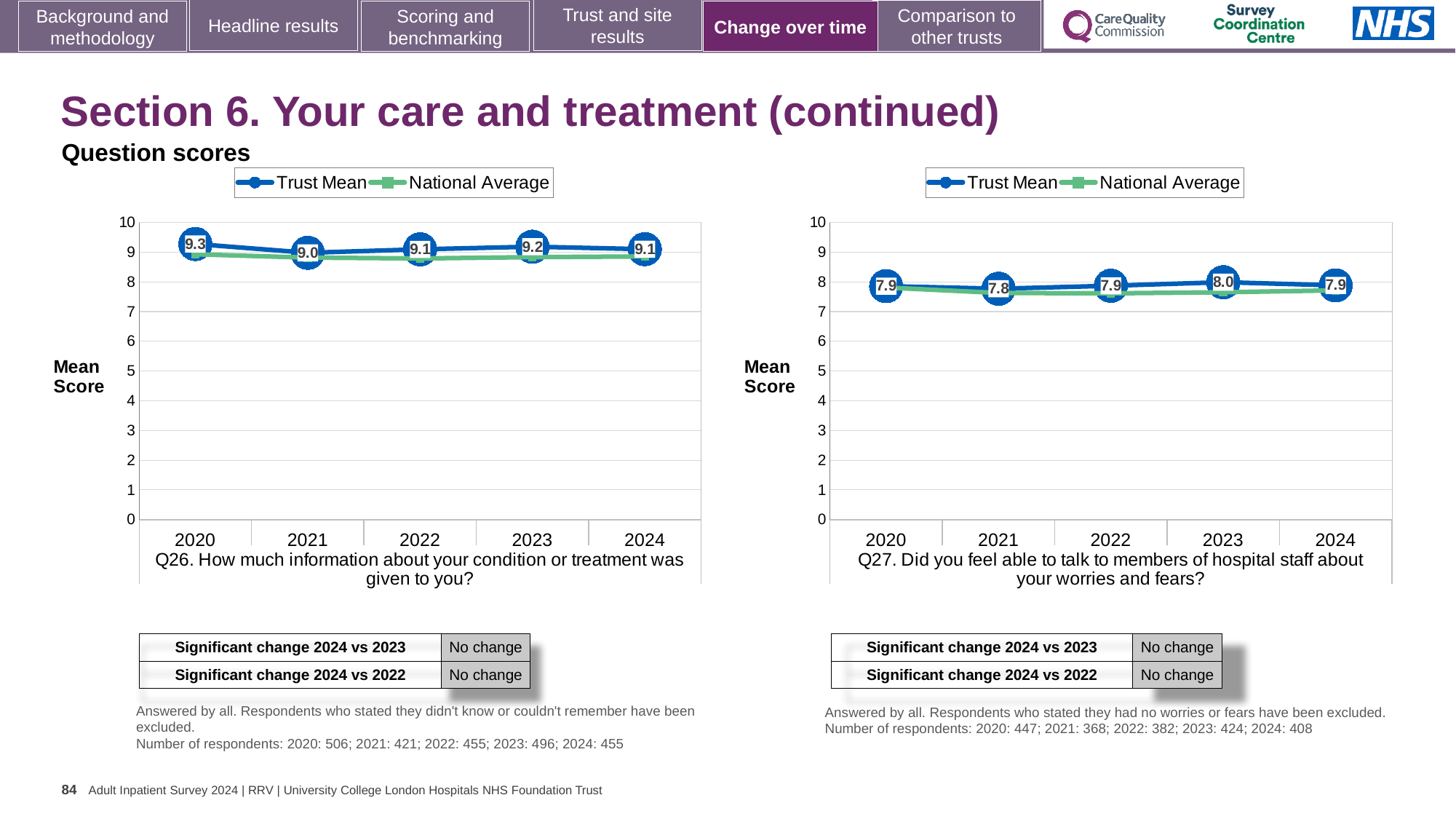
On the Q26 chart, what is the Trust Mean score for 2020? 9.3 On the Q27 chart, what is the Trust Mean score for 2023? 8.0 On the Q26 chart, which year has the lowest Trust Mean score? 2021 On the Q26 chart, what is the difference between the Trust Mean scores for 2020 and 2021? 0.3 What kind of chart is used for Q27? Line chart On the Q26 chart, does the Trust Mean score rise or fall from 2020 to 2021? Fall How many series does the legend of the Q26 chart list? 2 On the Q26 chart, is the National Average value for 2020 greater or less than 8? greater On the Q26 chart, which year has the highest Trust Mean score? 2020 On the Q27 chart, which year has the lowest Trust Mean score? 2021 On the Q27 chart, is the Trust Mean score higher in 2023 or in 2021? 2023 How many years are plotted on the Q27 chart? 5